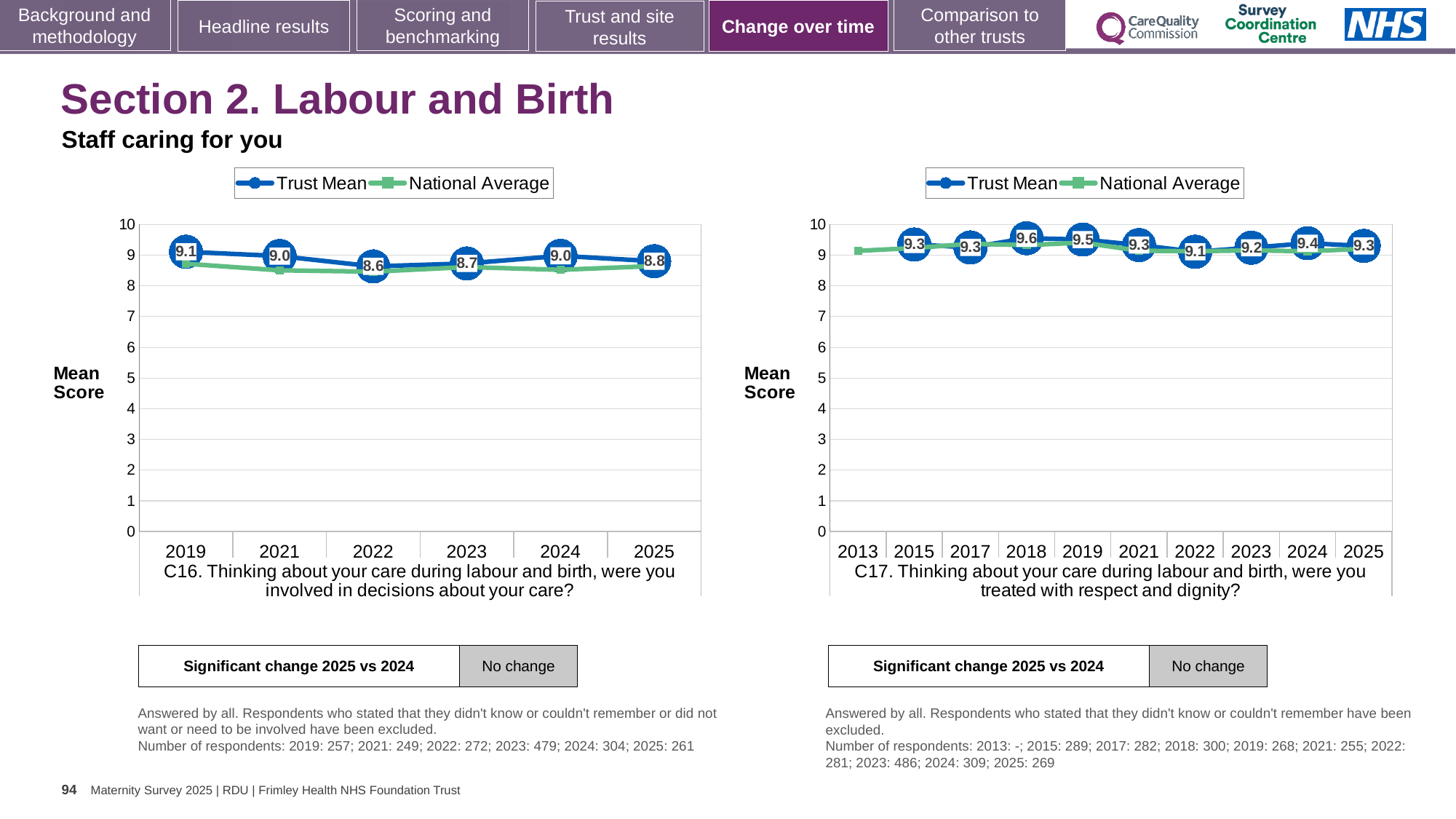
In the C16 chart (left), what is the Trust Mean for 2022? 8.6 In the C17 chart (right), what is the Trust Mean for 2025? 9.3 In the C16 chart (left), what is the Trust Mean for 2019? 9.1 In the C16 chart (left), how many years are shown on the x axis? 6 In the C16 chart (left), what is the difference between the Trust Mean for 2019 and for 2022? 0.5 In the C17 chart (right), what is the Trust Mean for 2018? 9.6 In the C17 chart (right), how many years are shown on the x axis? 10 In the C16 chart (left), which year has the lowest Trust Mean? 2022 How many series does the legend of the C16 chart (left) list? 2 What type of chart is the C17 chart (right)? Line chart In the C17 chart (right), which year has the highest Trust Mean? 2018 In the C17 chart (right), which year has the lowest Trust Mean? 2022